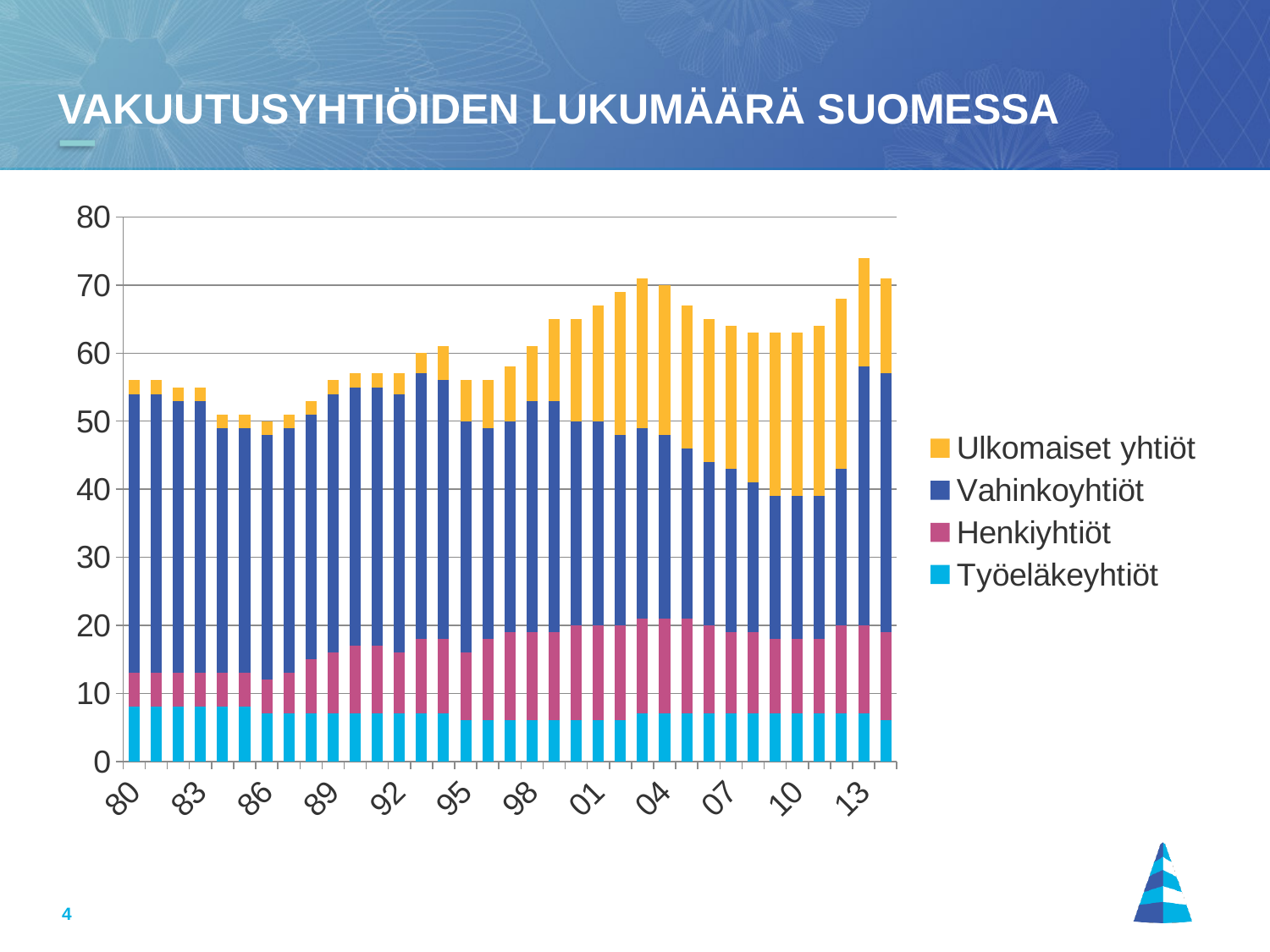
What kind of chart is shown on the slide? Stacked bar chart Is the total value for 13 greater or less than 70? greater Which has the larger total bar, 04 or 10? 04 Is the total value for 80 greater or less than 50? greater How many series does the legend list? 4 What is the title of the chart? VAKUUTUSYHTIÖIDEN LUKUMÄÄRÄ SUOMESSA Which year has the highest total bar? 13 Is the total value for 10 greater or less than 60? greater Do the total bar heights rise or fall from 04 to 10? fall How many year labels are shown on the x axis? 12 Which series is listed first (at the top) in the legend? Ulkomaiset yhtiöt